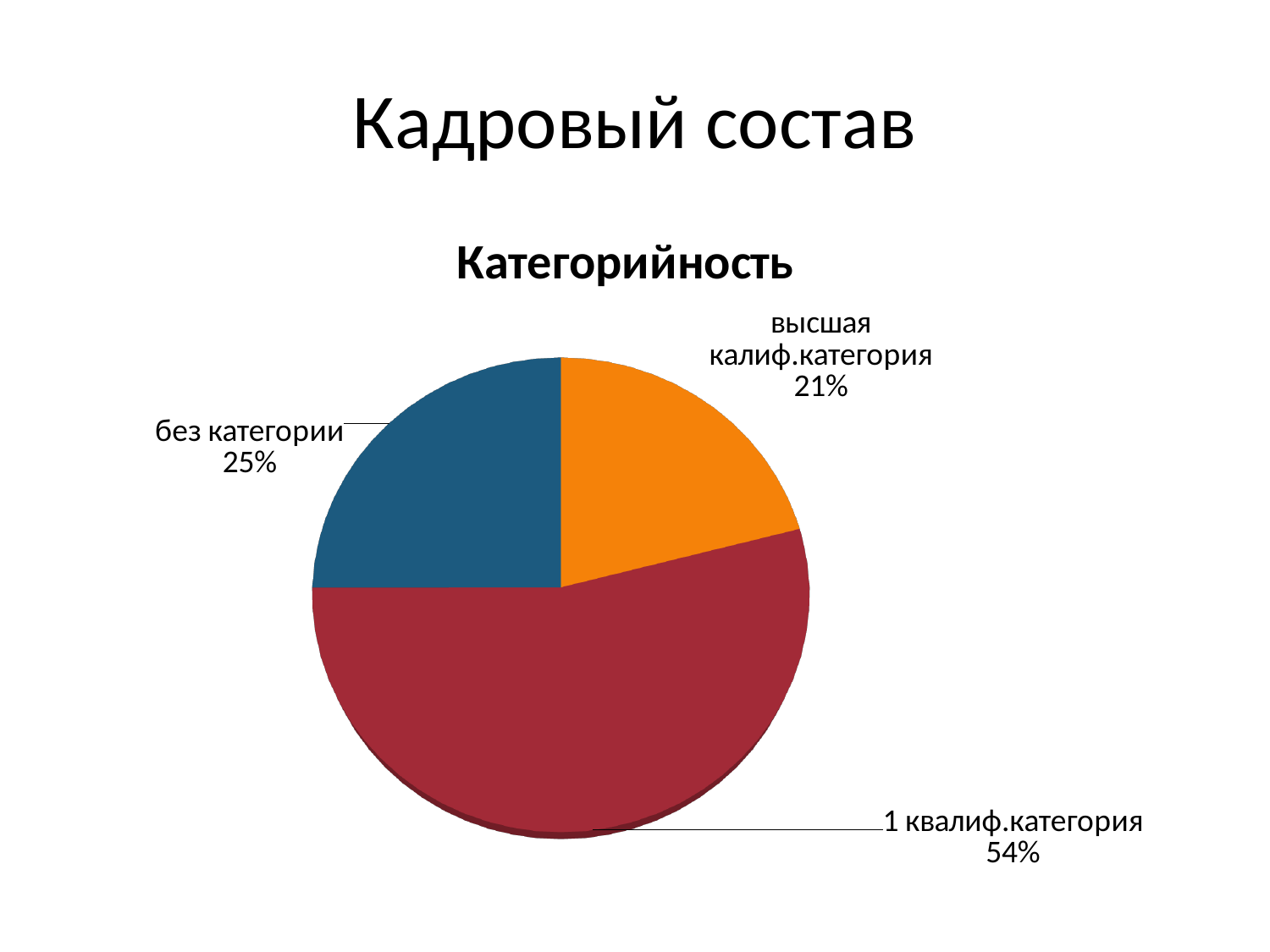
Which category has the smallest share of the pie? высшая калиф.категория What is the title of the chart? Категорийность What share of the pie is labelled "без категории"? 25% What is the difference in percentage points between "без категории" and "высшая калиф.категория"? 4 What type of chart is shown on the slide? pie chart What colour is the slice for "1 квалиф.категория"? red What share of the pie is labelled "1 квалиф.категория"? 54% What is the difference in percentage points between "1 квалиф.категория" and "без категории"? 29 Which category has the largest share of the pie? 1 квалиф.категория Which is larger: the share for "без категории" or the share for "высшая калиф.категория"? без категории How many slices does the pie chart have? 3 What share of the pie is labelled "высшая калиф.категория"? 21%